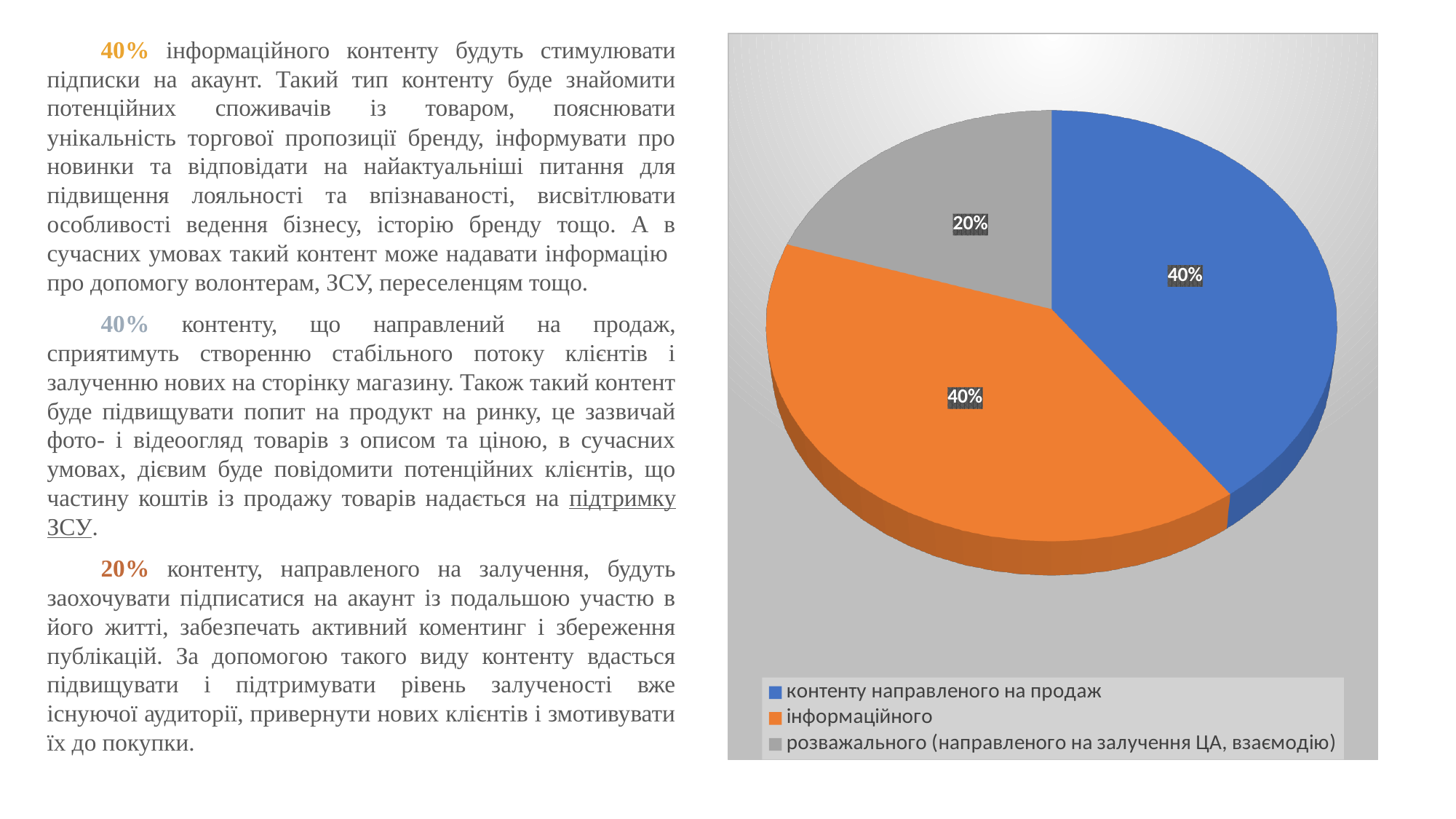
How many slices does the pie chart have? 3 Which legend entry is shown in gray in the pie chart? розважального (направленого на залучення ЦА, взаємодію) What kind of chart is shown on the slide? pie chart What share of the pie does "контенту направленого на продаж" have? 40% How many entries does the legend of the pie chart list? 3 Which slice of the pie chart is the smallest? розважального (направленого на залучення ЦА, взаємодію) What share of the pie does "інформаційного" have? 40% What is the combined share of "контенту направленого на продаж" and "інформаційного"? 80% What colour is the slice for "інформаційного" in the pie chart? orange What is the difference between the share of "інформаційного" and the share of "розважального (направленого на залучення ЦА, взаємодію)"? 20% What share of the pie does "розважального (направленого на залучення ЦА, взаємодію)" have? 20% Which is larger: the share of "контенту направленого на продаж" or the share of "розважального (направленого на залучення ЦА, взаємодію)"? контенту направленого на продаж